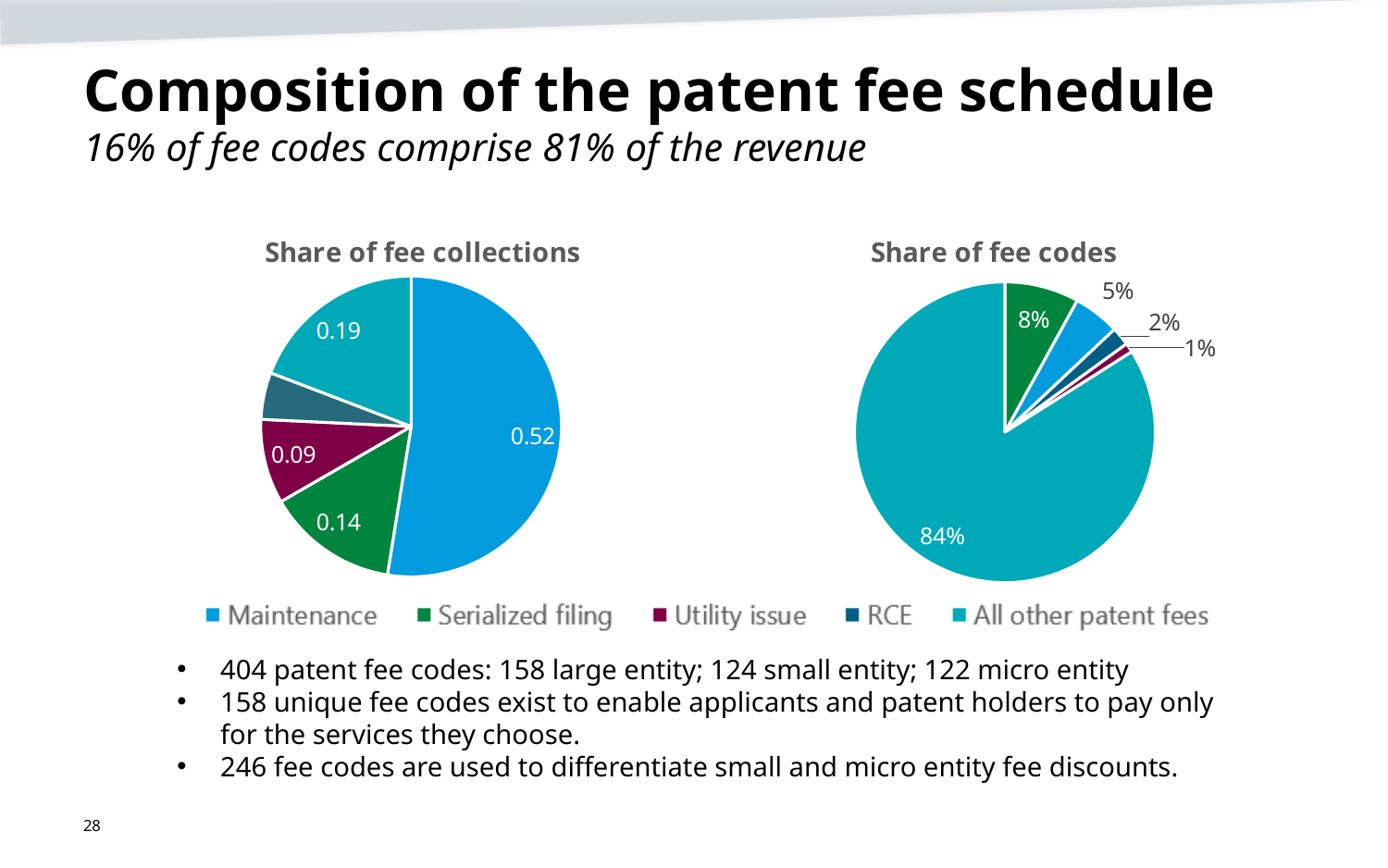
In the 'Share of fee codes' chart, what is the value for All other patent fees? 84% In the 'Share of fee collections' chart, what is the value for Maintenance? 0.52 In the 'Share of fee codes' chart, what is the value for Maintenance? 5% In the 'Share of fee collections' chart, what is the value for All other patent fees? 0.19 In the 'Share of fee collections' chart, which category has the largest slice? Maintenance In the 'Share of fee collections' chart, what is the value for Serialized filing? 0.14 In the 'Share of fee codes' chart, what is the value for Serialized filing? 8% What type of chart is the 'Share of fee codes' chart? Pie chart In the 'Share of fee collections' chart, what is the difference between the Maintenance value and the Serialized filing value? 0.38 In the 'Share of fee codes' chart, which is larger, the slice for Serialized filing or the slice for Maintenance? Serialized filing How many entries does the shared legend list? 5 In the 'Share of fee codes' chart, which category has the smallest slice? Utility issue